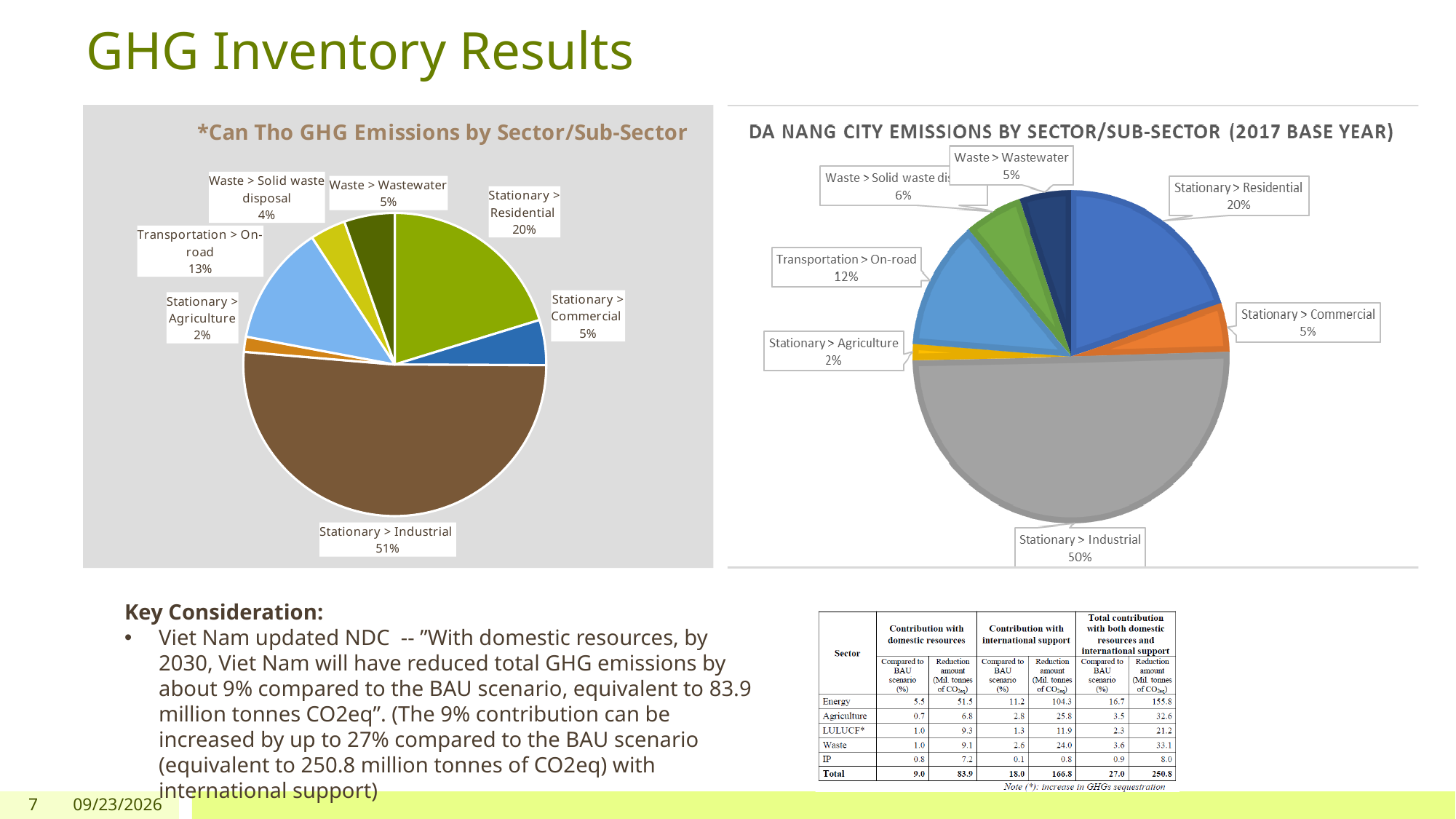
In the Da Nang City Emissions by Sector/Sub-Sector chart, what share of emissions comes from Stationary > Industrial? 50% In the Can Tho GHG Emissions by Sector/Sub-Sector chart, how many slices does the pie have? 7 In the Can Tho GHG Emissions by Sector/Sub-Sector chart, what share of emissions comes from Transportation > On-road? 13% What type of chart is the Da Nang City Emissions by Sector/Sub-Sector chart? Pie chart What base year is stated in the title of the Da Nang City Emissions by Sector/Sub-Sector chart? 2017 In the Da Nang City Emissions by Sector/Sub-Sector chart, which is larger: Stationary > Residential or Waste > Wastewater? Stationary > Residential In the Da Nang City Emissions by Sector/Sub-Sector chart, what share of emissions comes from Transportation > On-road? 12% In the Can Tho GHG Emissions by Sector/Sub-Sector chart, which sector/sub-sector has the smallest share? Stationary > Agriculture In the Da Nang City Emissions by Sector/Sub-Sector chart, which sector/sub-sector has the largest share? Stationary > Industrial In the Can Tho GHG Emissions by Sector/Sub-Sector chart, what is the difference between the Stationary > Residential share and the Waste > Solid waste disposal share? 16% In the Can Tho GHG Emissions by Sector/Sub-Sector chart, what share of emissions comes from Stationary > Industrial? 51% In the Da Nang City Emissions by Sector/Sub-Sector chart, what is the difference between the Transportation > On-road share and the Stationary > Agriculture share? 10%